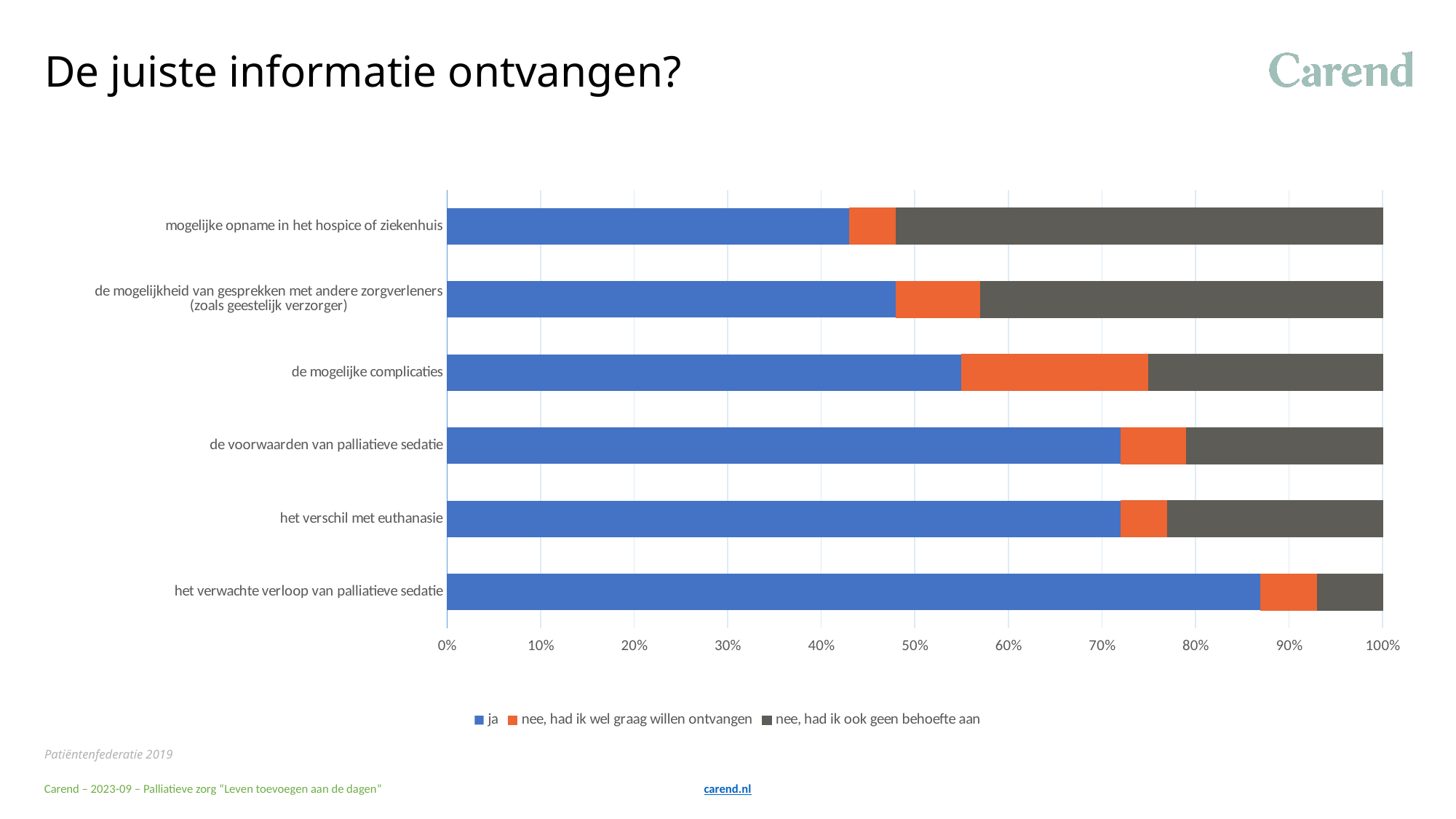
Which category has the largest share of 'nee, had ik wel graag willen ontvangen'? de mogelijke complicaties Is the 'ja' share for 'mogelijke opname in het hospice of ziekenhuis' greater or less than 50%? less Which category has the largest share of 'ja'? het verwachte verloop van palliatieve sedatie What colour represents the 'ja' series in the chart? blue Which category has the smallest share of 'ja'? mogelijke opname in het hospice of ziekenhuis Is the 'ja' share for 'de voorwaarden van palliatieve sedatie' greater or less than 70%? greater How many series does the legend list? 3 What kind of chart is shown on the slide? stacked bar chart Which category has the largest share of 'nee, had ik ook geen behoefte aan'? mogelijke opname in het hospice of ziekenhuis How many categories (information topics) are shown on the chart? 6 Which has a larger 'ja' share: 'de mogelijke complicaties' or 'de mogelijkheid van gesprekken met andere zorgverleners (zoals geestelijk verzorger)'? de mogelijke complicaties Is the 'ja' share for 'het verwachte verloop van palliatieve sedatie' greater or less than 80%? greater